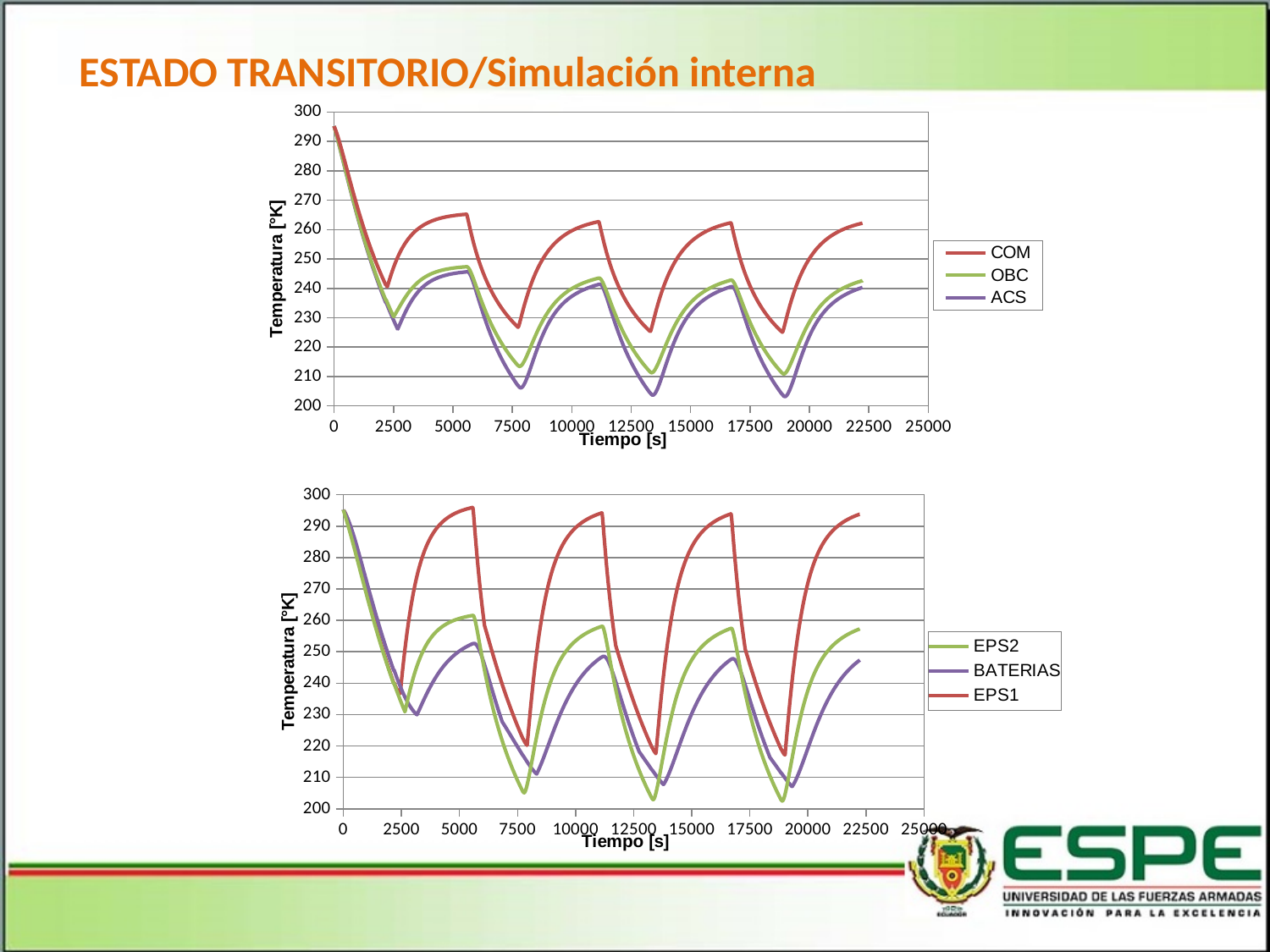
How many series does the legend of the top chart list? 3 What is the label of the vertical axis on the bottom chart? Temperatura [°K] In the top chart, is the first peak of the COM series (around 5500 s) greater or less than 260? greater In the bottom chart, is the lowest value of the EPS2 series greater or less than 210? less In the bottom chart, which series reaches the lowest temperature? EPS2 What kind of chart is the top chart on the slide? line chart In the bottom chart, which series reaches the highest temperatures? EPS1 In the bottom chart, are the peaks of the EPS1 series greater or less than 290? greater How many series does the legend of the bottom chart list? 3 In the top chart, which series reaches the lowest temperature? ACS In the top chart, which series reaches the highest temperatures after the initial drop? COM